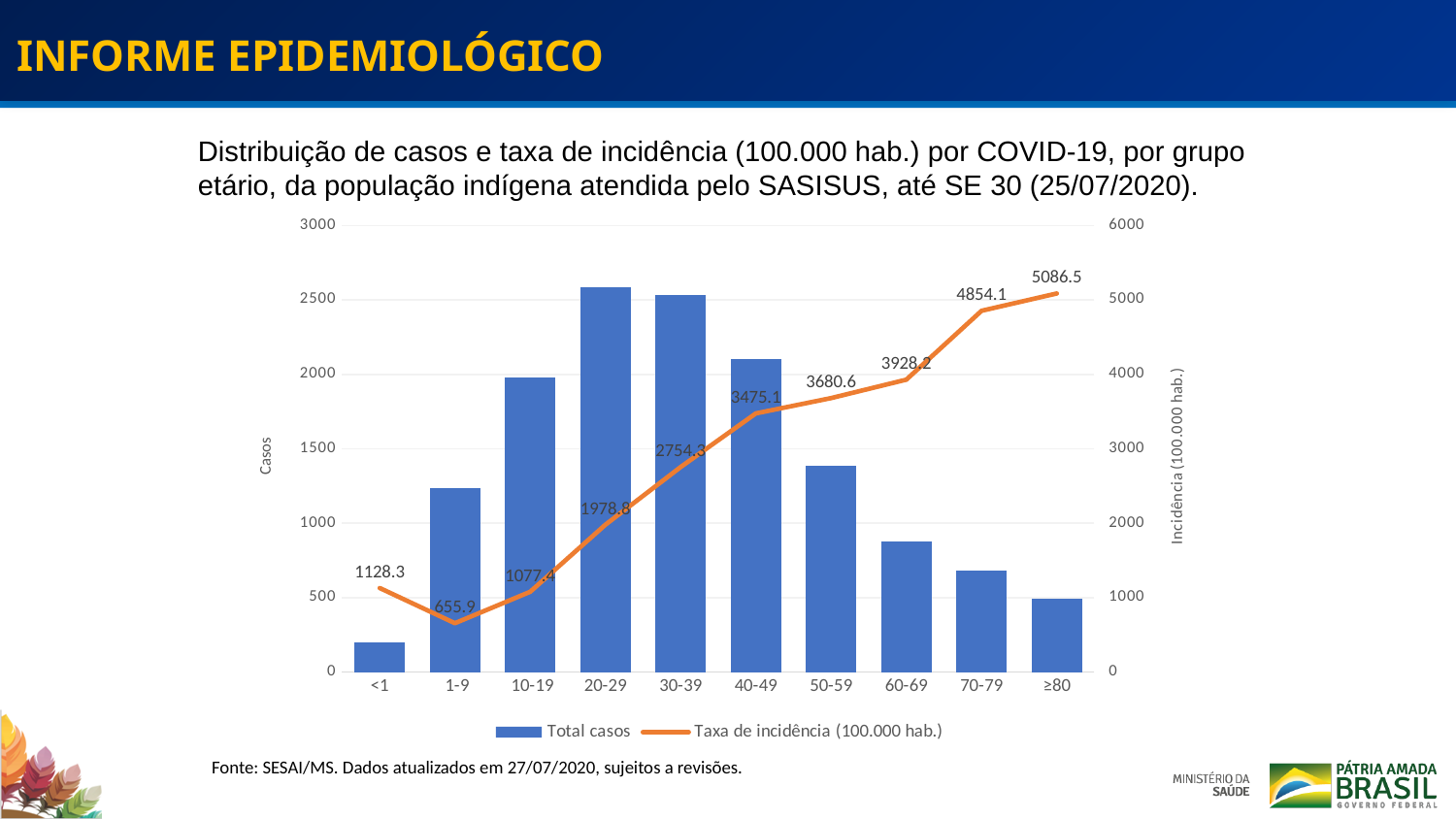
Which age group has the highest incidence rate? ≥80 Does the incidence rate rise or fall from the 1-9 age group to the ≥80 age group? rise What is the difference between the incidence rates of the ≥80 and 70-79 age groups? 232.4 Which age group has the lowest number of Total casos? <1 Which age group has the lowest incidence rate? 1-9 How many age groups are shown on the x axis? 10 What is the incidence rate (Taxa de incidência) for the ≥80 age group? 5086.5 Is the value of Total casos for the 20-29 age group greater or less than 2500? greater How many series does the legend list? 2 Is the value of Total casos for the <1 age group greater or less than 500? less What is the incidence rate (Taxa de incidência) for the 40-49 age group? 3475.1 Which age group has a higher incidence rate, <1 or 1-9? <1